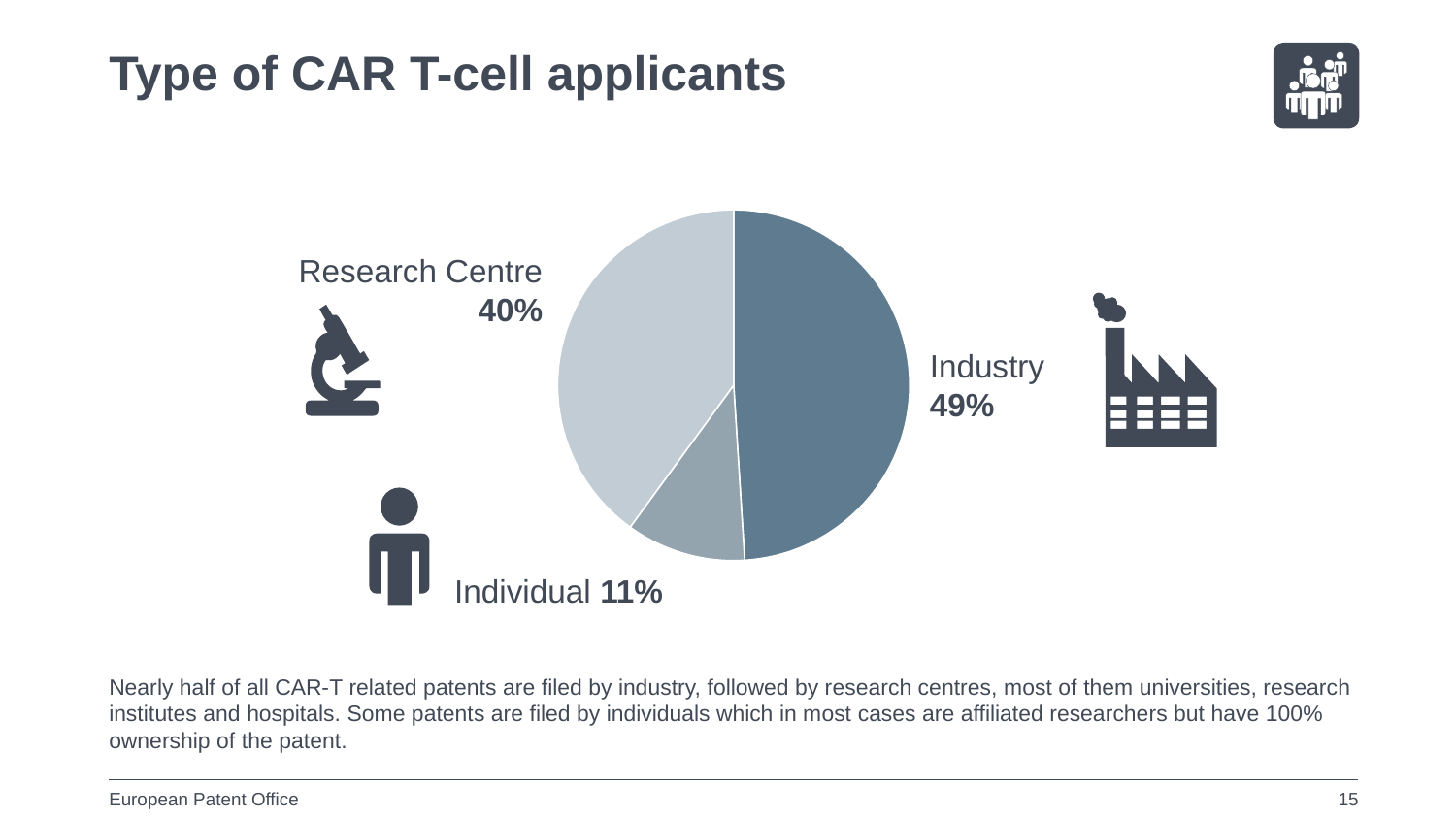
Which is larger, the share for Research Centre or the share for Individual? Research Centre Which applicant type is represented by the darkest slice of the pie? Industry Which type of applicant has the smallest share of the pie? Individual What is the title of the slide containing the chart? Type of CAR T-cell applicants Which type of applicant has the largest share of the pie? Industry What kind of chart is shown on the slide? Pie chart What share of CAR T-cell applicants is Research Centre? 40% What share of CAR T-cell applicants is Individual? 11% How many applicant types are shown in the pie chart? 3 What is the difference in percentage points between the Research Centre and Individual shares? 29 What is the difference in percentage points between the Industry and Research Centre shares? 9 What share of CAR T-cell applicants is Industry? 49%